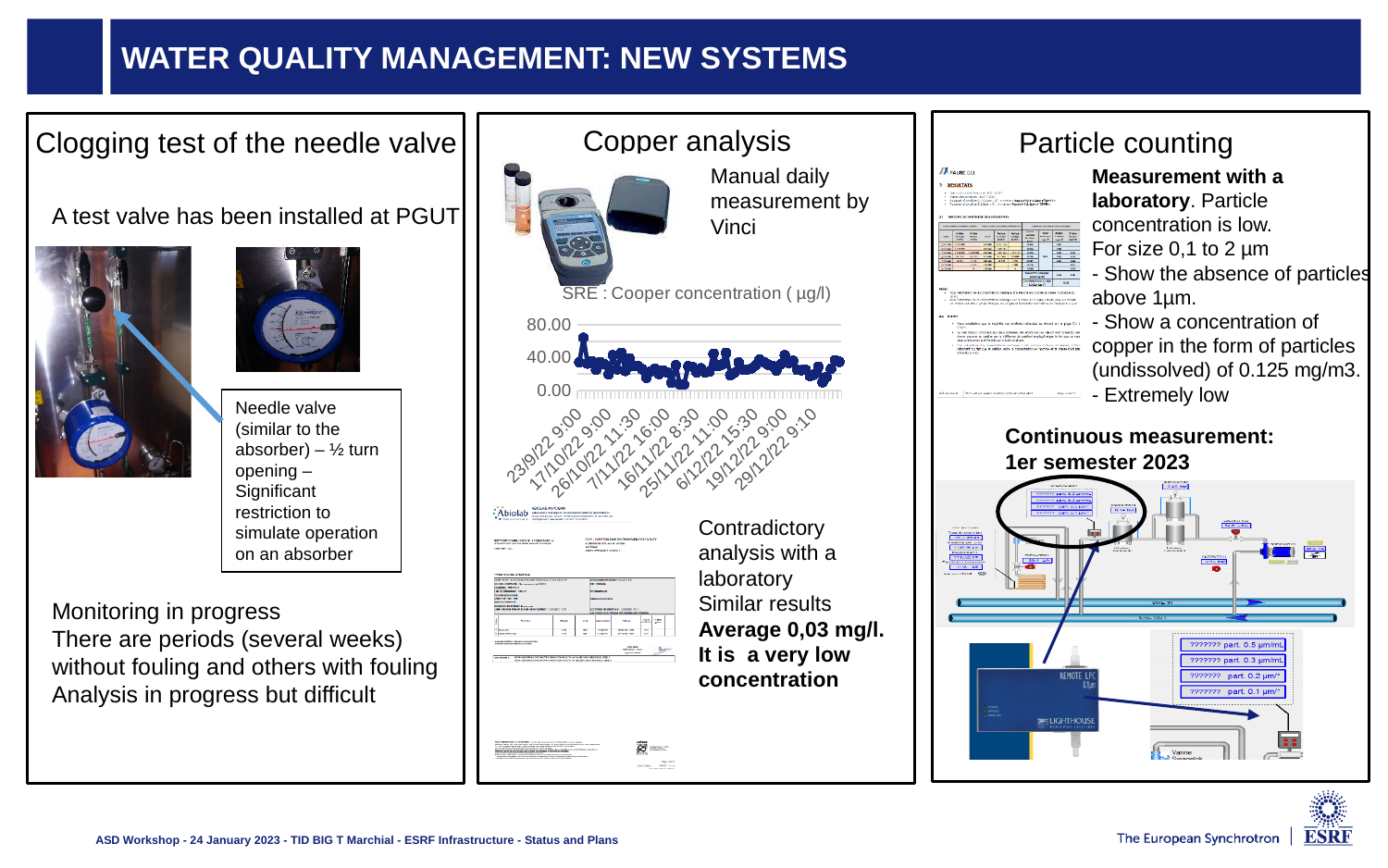
What unit is given in the title of the copper concentration chart? µg/l What is the last date label on the x axis of the copper concentration chart? 29/12/22 9:10 How many y-axis tick labels are shown on the copper concentration chart? 3 Are all the plotted values in the copper concentration chart greater or less than 80? less What is the first date label on the x axis of the copper concentration chart? 23/9/22 9:00 Is the value plotted at 23/9/22 9:00 in the copper concentration chart greater or less than 80? less How many date labels are printed along the x axis of the copper concentration chart? 9 What kind of chart is shown under the title "SRE : Cooper concentration ( µg/l)"? line chart What is the highest value shown on the y axis of the copper concentration chart? 80.00 What is the title of the chart on the Copper analysis panel? SRE : Cooper concentration ( µg/l)